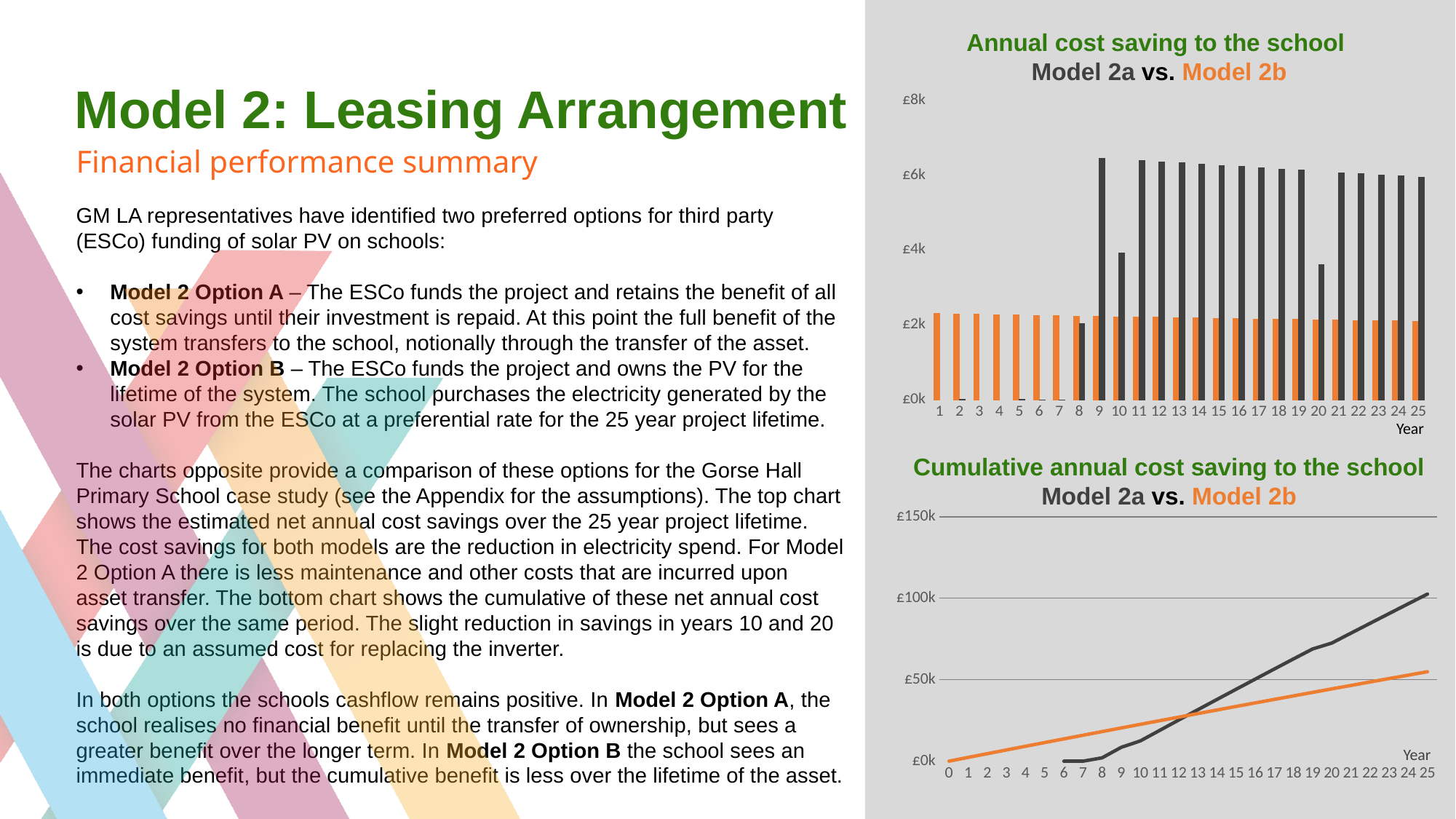
In the bottom chart, 'Cumulative annual cost saving to the school', does the Model 2b line rise or fall from year 0 to year 25? rise What kind of chart is the top chart, 'Annual cost saving to the school'? bar chart What kind of chart is the bottom chart, 'Cumulative annual cost saving to the school'? line chart In the top chart, 'Annual cost saving to the school', is the Model 2b value for year 1 greater or less than £4k? less In the bottom chart, 'Cumulative annual cost saving to the school', which model has the higher value at year 25? Model 2a In the top chart, 'Annual cost saving to the school', which model has the larger value in year 3? Model 2b In the top chart, 'Annual cost saving to the school', how many years are shown on the x axis? 25 In the bottom chart, 'Cumulative annual cost saving to the school', is the Model 2b value at year 25 greater or less than £100k? less In the top chart, 'Annual cost saving to the school', is the Model 2a value for year 10 greater or less than £2k? greater In the top chart, 'Annual cost saving to the school', in which year is the Model 2a bar highest? Year 9 In the top chart, 'Annual cost saving to the school', which model has the larger value in year 15? Model 2a